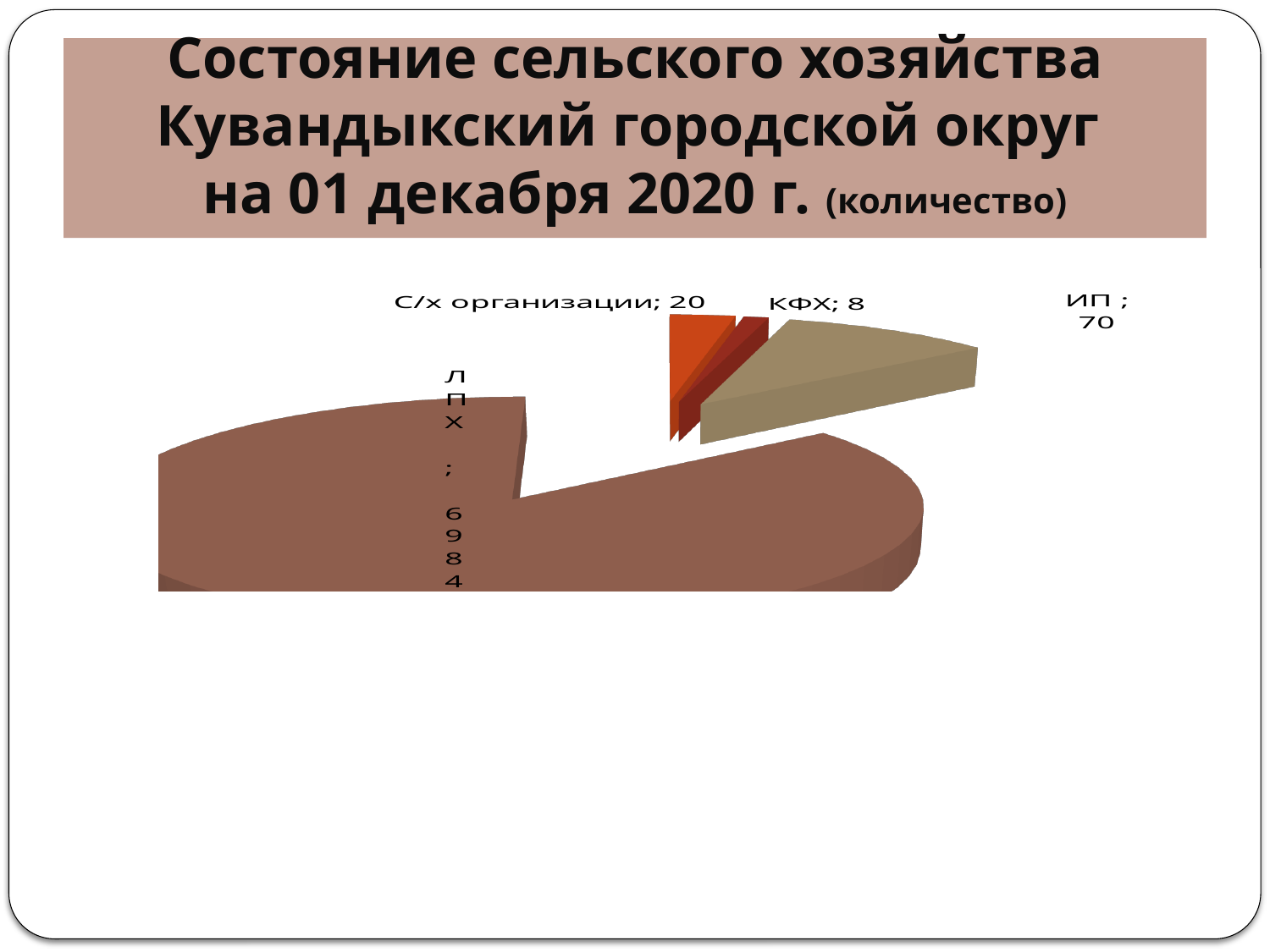
Which category has the largest value? ЛПХ What date does the chart title say the data refers to? 01 декабря 2020 г. What is the value for ЛПХ? 6984 What is the difference between the values for ИП and С/х организации? 50 How many categories (slices) does the pie chart have? 4 Which is larger, the value for ИП or the value for КФХ? ИП What is the value for С/х организации? 20 What is the difference between the values for С/х организации and КФХ? 12 What is the value for КФХ? 8 What type of chart is shown on the slide? Pie chart What is the value for ИП? 70 Which category has the smallest value? КФХ